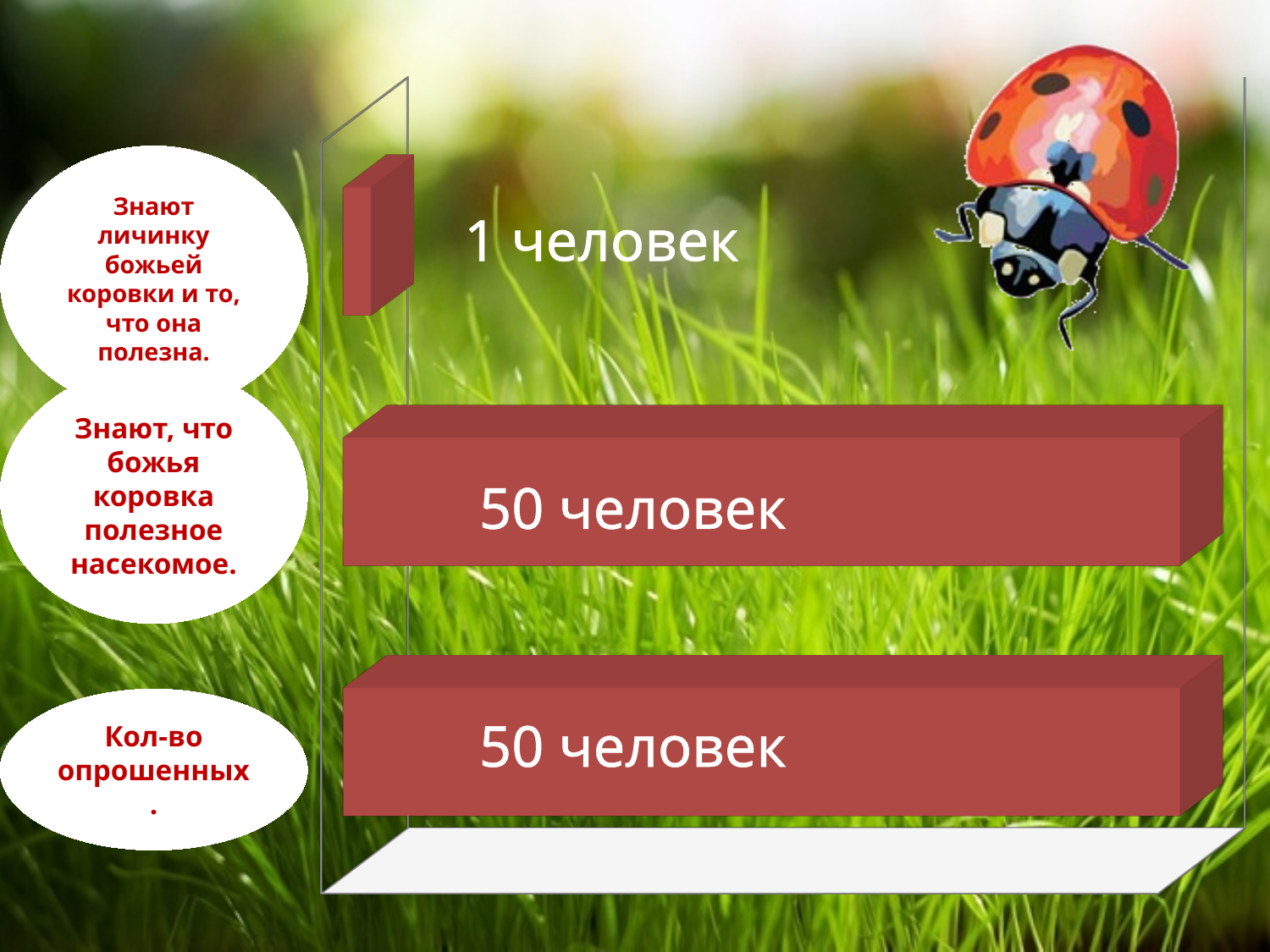
How many people know that the ladybird is a useful insect ("Знают, что божья коровка полезное насекомое")? 50 человек How many people know the ladybird larva and that it is useful ("Знают личинку божьей коровки и то, что она полезна")? 1 человек What is the number of respondents ("Кол-во опрошенных") shown on the chart? 50 человек What kind of chart is shown on the slide? bar chart What is the difference between the number of respondents and the number who know the ladybird larva? 49 Which category has the lowest value on the chart? Знают личинку божьей коровки и то, что она полезна. How many categories (bars) are shown on the chart? 3 Are the bars on the chart horizontal or vertical? horizontal Is the value for "Знают, что божья коровка полезное насекомое" equal to the total number of respondents? Yes What colour are the bars on the chart? red Which is larger: the number who know the ladybird is a useful insect, or the number who know its larva? Знают, что божья коровка полезное насекомое.